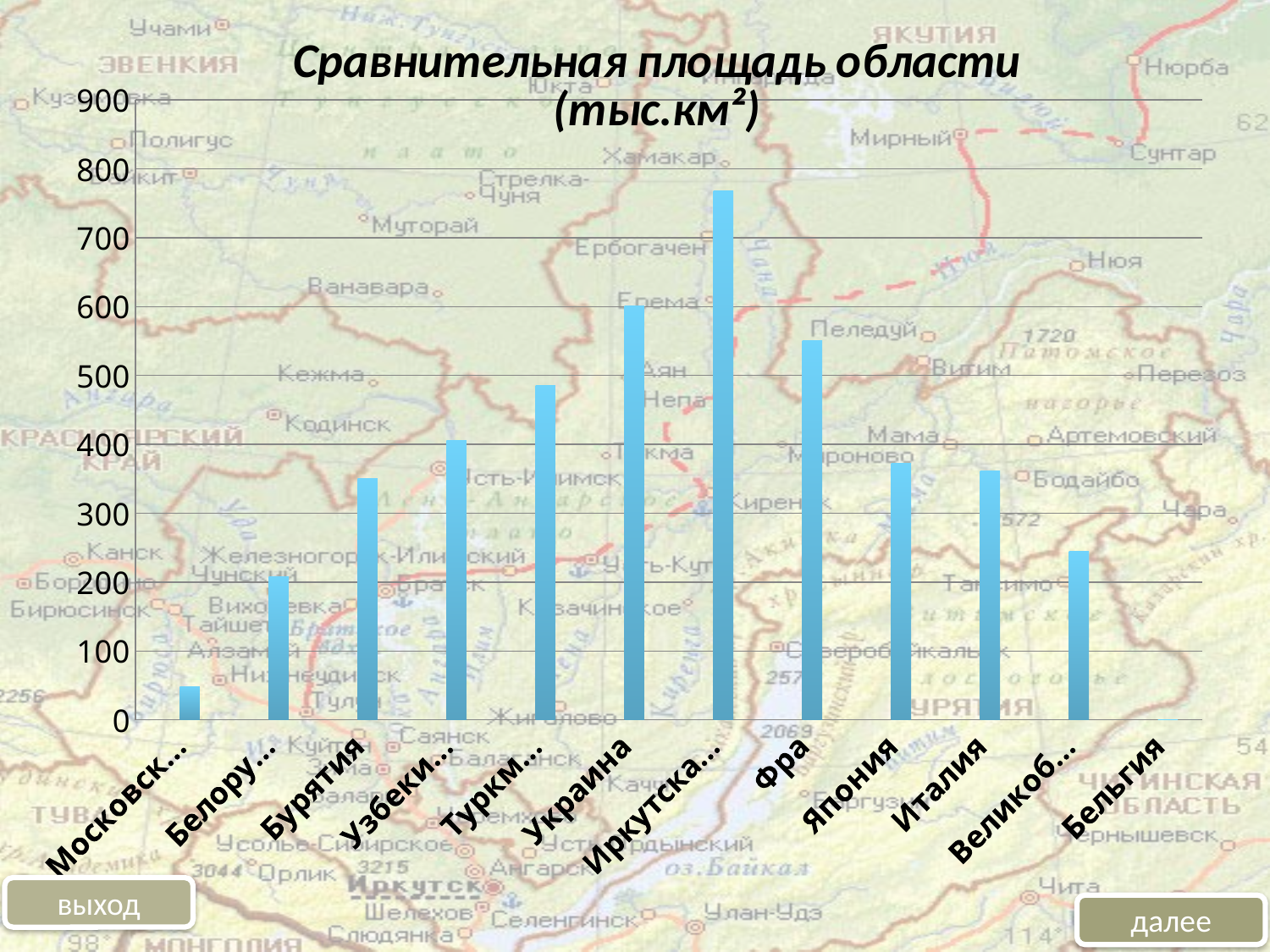
Is the value for Япония greater or less than 300? greater Which has a larger value, Украина or Япония? Украина Which category has the highest value in the chart? Иркутска… Is the value for Бельгия greater or less than 100? less Is the value for Украина greater or less than 500? greater Which category has the lowest value in the chart? Бельгия Which has a larger value, Фра or Бурятия? Фра What is the title of the chart? Сравнительная площадь области (тыс.км²) What kind of chart is shown on the slide? bar chart How many categories (bars) are shown in the chart? 12